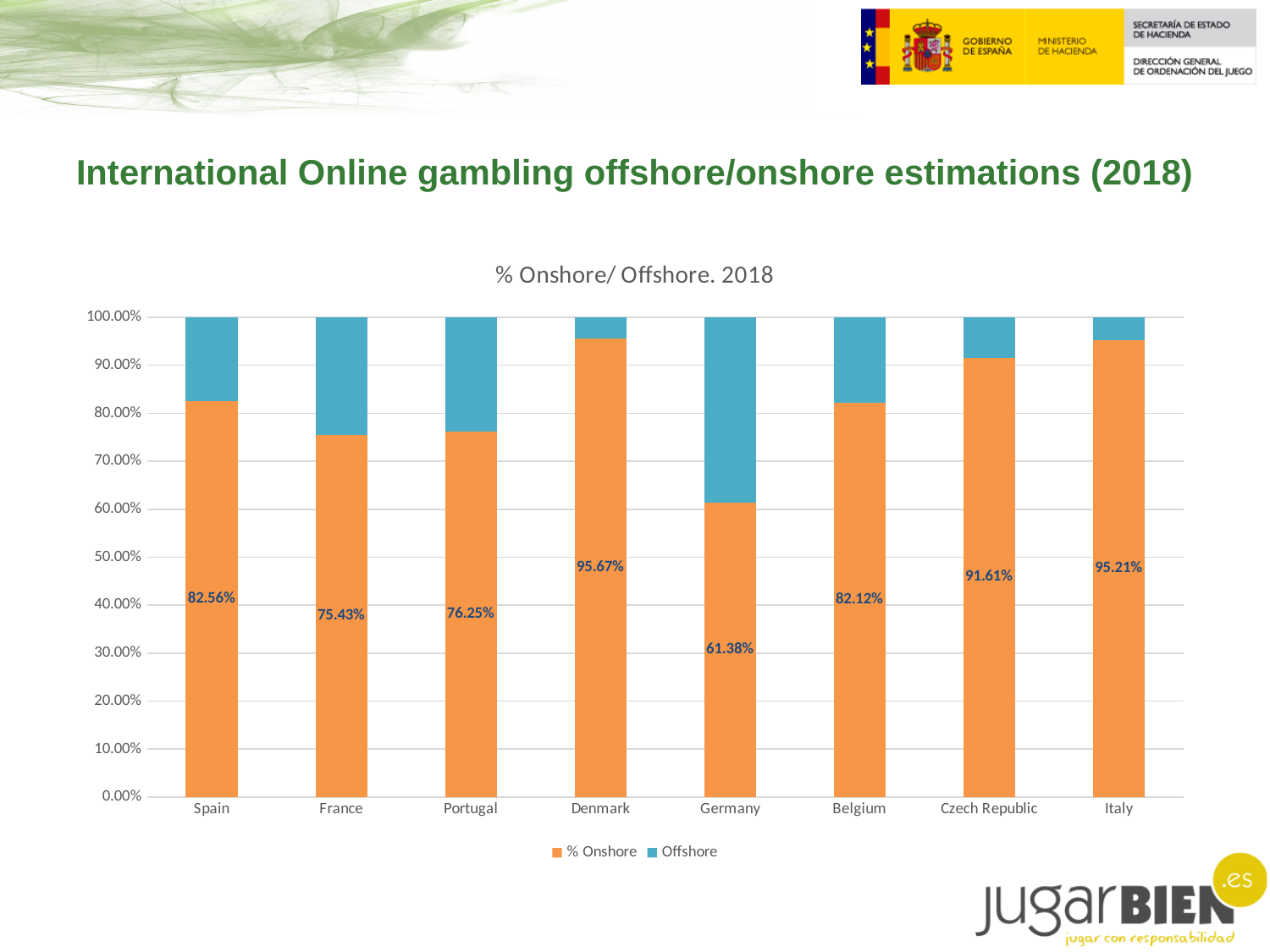
What is the title of the chart? % Onshore/ Offshore. 2018 Which country has the lowest % Onshore value? Germany What is the % Onshore value for Spain? 82.56% What is the difference between the % Onshore values for Italy and France? 19.78% Which country has the highest % Onshore value? Denmark Which has a larger % Onshore value, Belgium or Portugal? Belgium How many countries are shown on the x axis of the chart? 8 Is the % Onshore value for Germany greater or less than 70.00%? less What type of chart is shown on the slide? Stacked bar chart What is the % Onshore value for Germany? 61.38% What is the % Onshore value for Czech Republic? 91.61% How many series does the chart legend list? 2